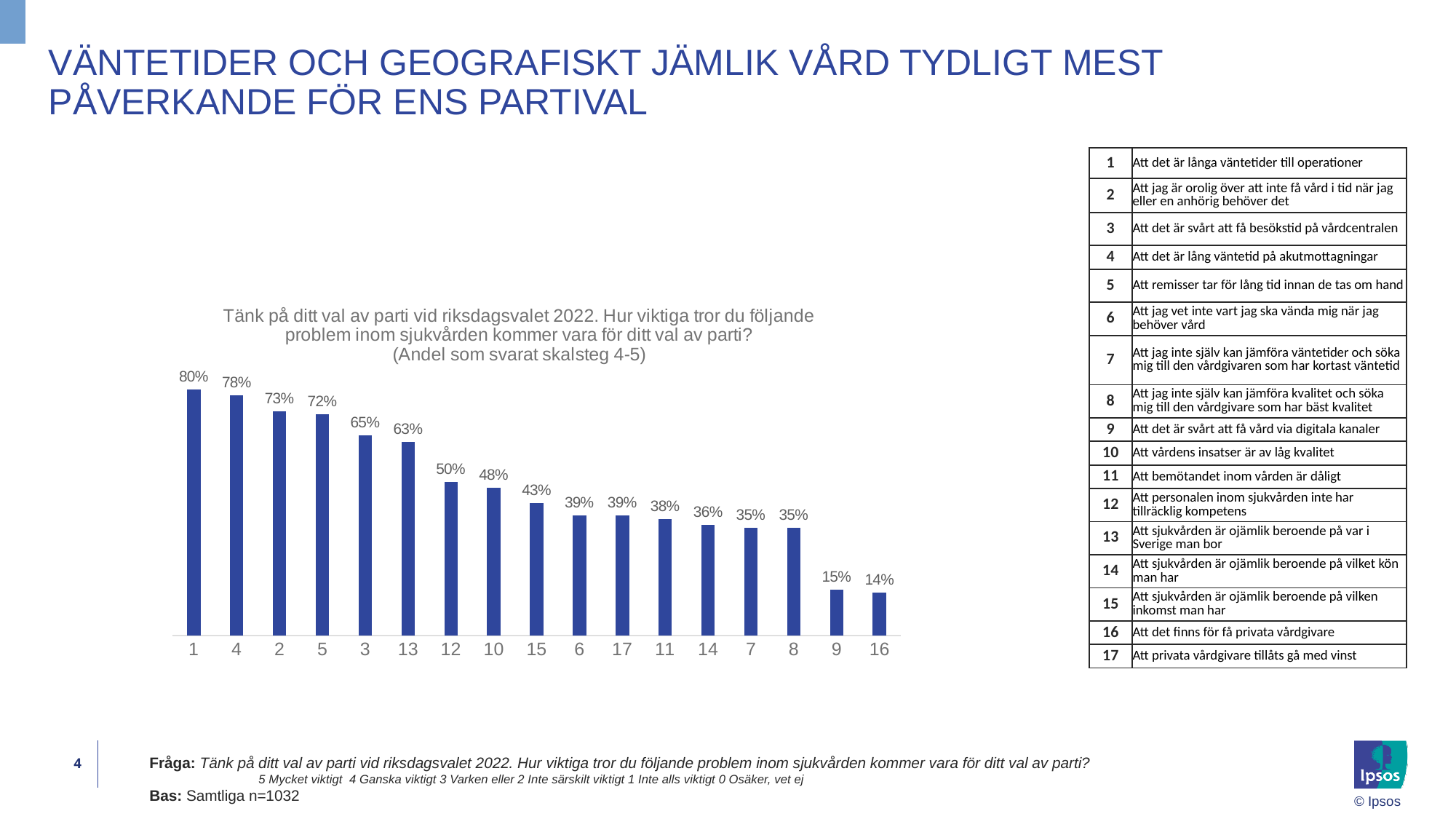
How many categories are shown in the chart? 17 Which category has the lowest value? 16 What is the difference between the values for category 12 and category 9? 35% What is the value for category 16? 14% What is the value for category 12? 50% What is the value for category 13? 63% What is the value for category 1? 80% Which has a larger value, category 5 or category 10? 5 What is the difference between the values for category 1 and category 4? 2% Which category has the highest value? 1 What kind of chart is shown on the slide? Bar chart Do the values rise or fall from left to right along the x axis? Fall